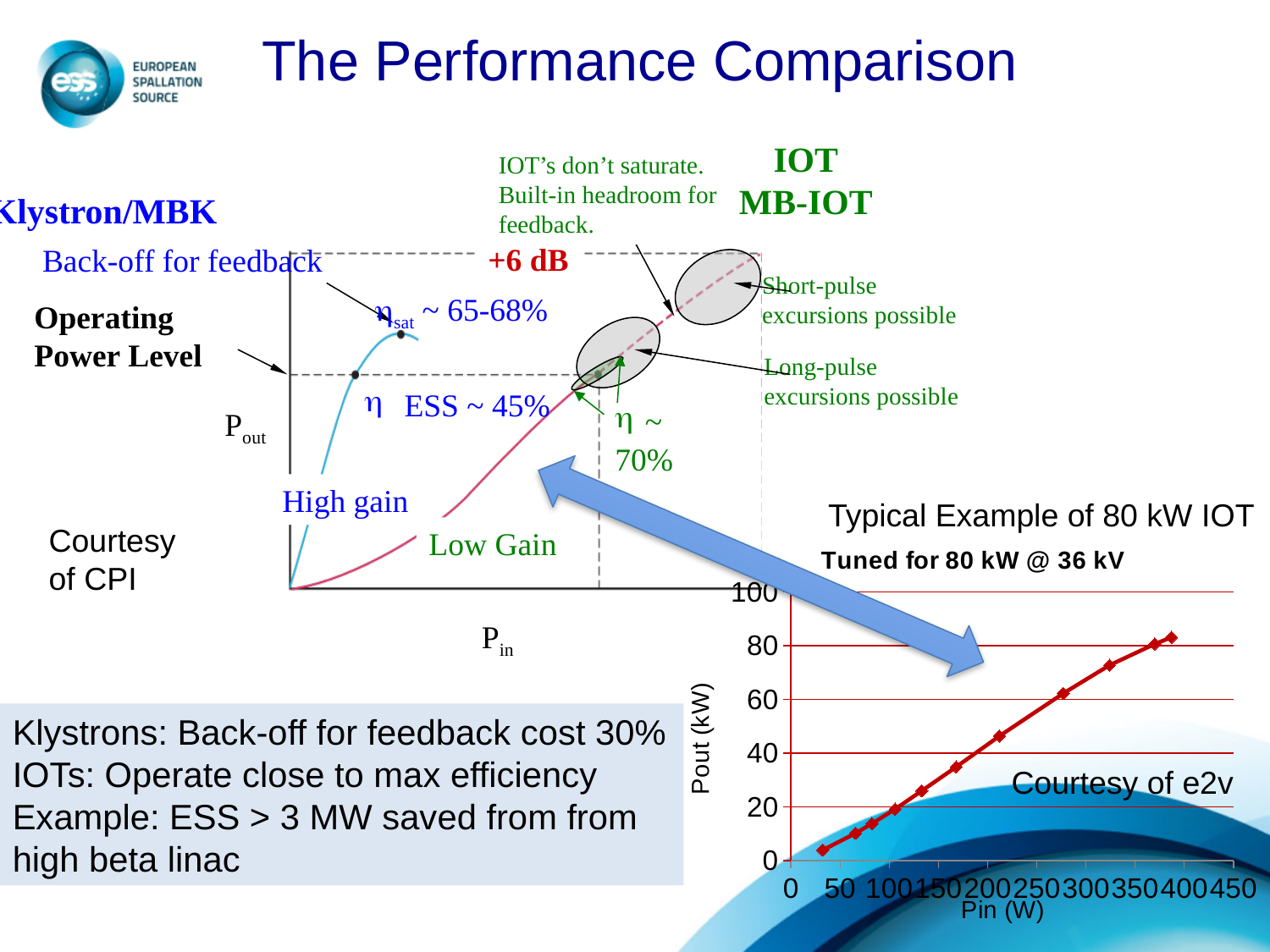
On the Pout vs Pin schematic chart on the left, how much headroom in dB is annotated above the operating power level? +6 dB On the chart titled 'Tuned for 80 kW @ 36 kV', is the Pout value at Pin = 100 W greater or less than 40? less On the Pout vs Pin schematic chart on the left, what saturated efficiency is annotated for the klystron curve? ~ 65-68% On the chart titled 'Tuned for 80 kW @ 36 kV', what is the label of the horizontal axis? Pin (W) On the chart titled 'Tuned for 80 kW @ 36 kV', what kind of chart is shown? line chart On the chart titled 'Tuned for 80 kW @ 36 kV', is the Pout value at Pin = 300 W greater or less than 60? greater On the Pout vs Pin schematic chart on the left, what efficiency is annotated for ESS on the klystron curve? ~ 45% On the Pout vs Pin schematic chart on the left, what efficiency is annotated for the IOT curve? ~ 70% On the chart titled 'Tuned for 80 kW @ 36 kV', does Pout rise or fall as Pin increases? rises On the chart titled 'Tuned for 80 kW @ 36 kV', is the Pout value at Pin = 250 W greater or less than 40? greater On the chart titled 'Tuned for 80 kW @ 36 kV', what is the label of the vertical axis? Pout (kW)